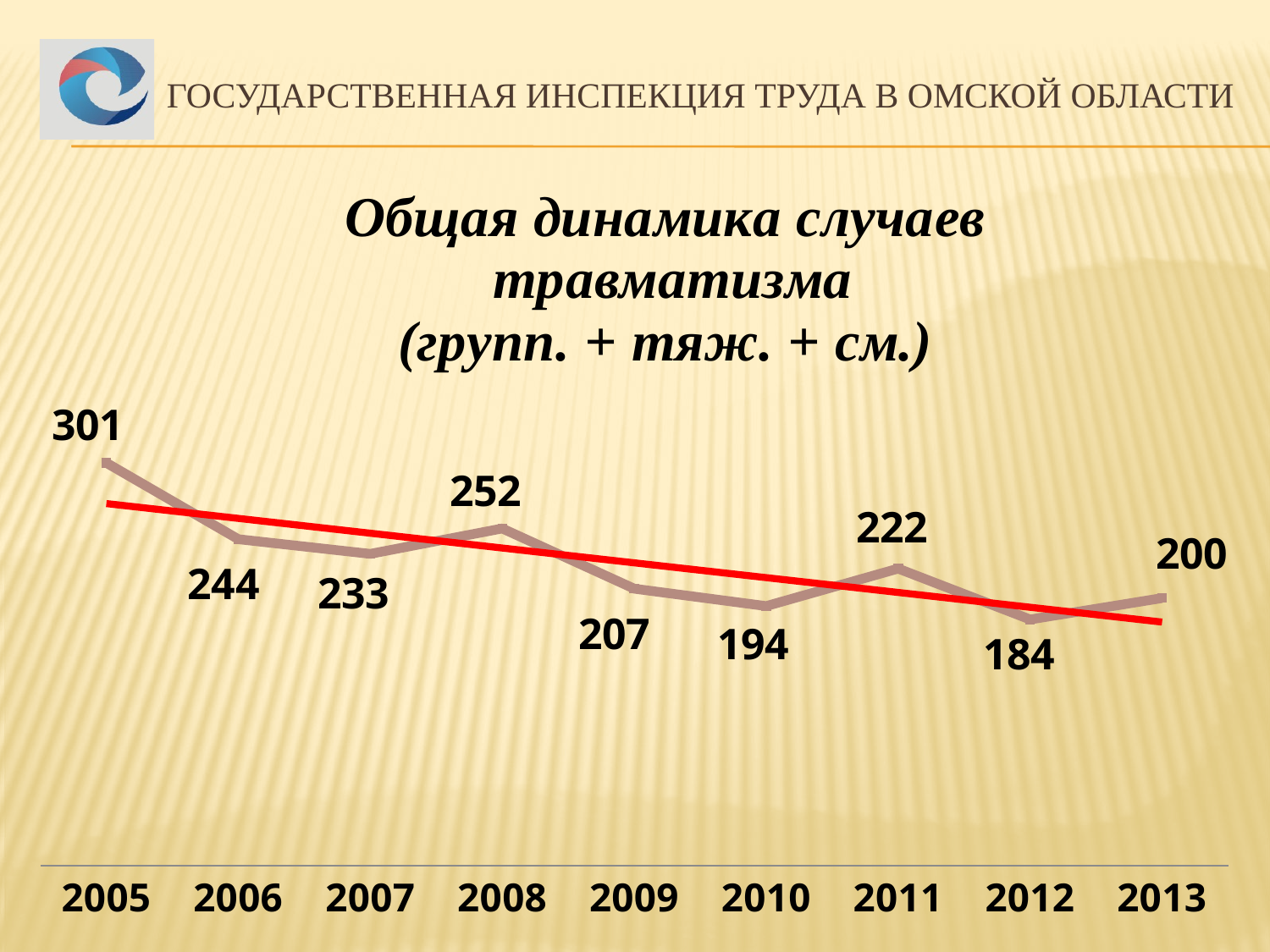
What kind of chart is shown on the slide? line chart What was the number of injury cases in 2010? 194 What colour is the straight trend line drawn across the chart? red What was the number of injury cases in 2013? 200 Which year had more injury cases, 2011 or 2012? 2011 Which year had the lowest number of injury cases? 2012 Which year had the highest number of injury cases? 2005 What is the difference between the number of cases in 2008 and in 2009? 45 Do the values generally rise or fall from 2005 to 2013? fall How many years are shown on the x axis? 9 What is the difference between the number of cases in 2005 and in 2013? 101 What was the number of injury cases in 2005? 301